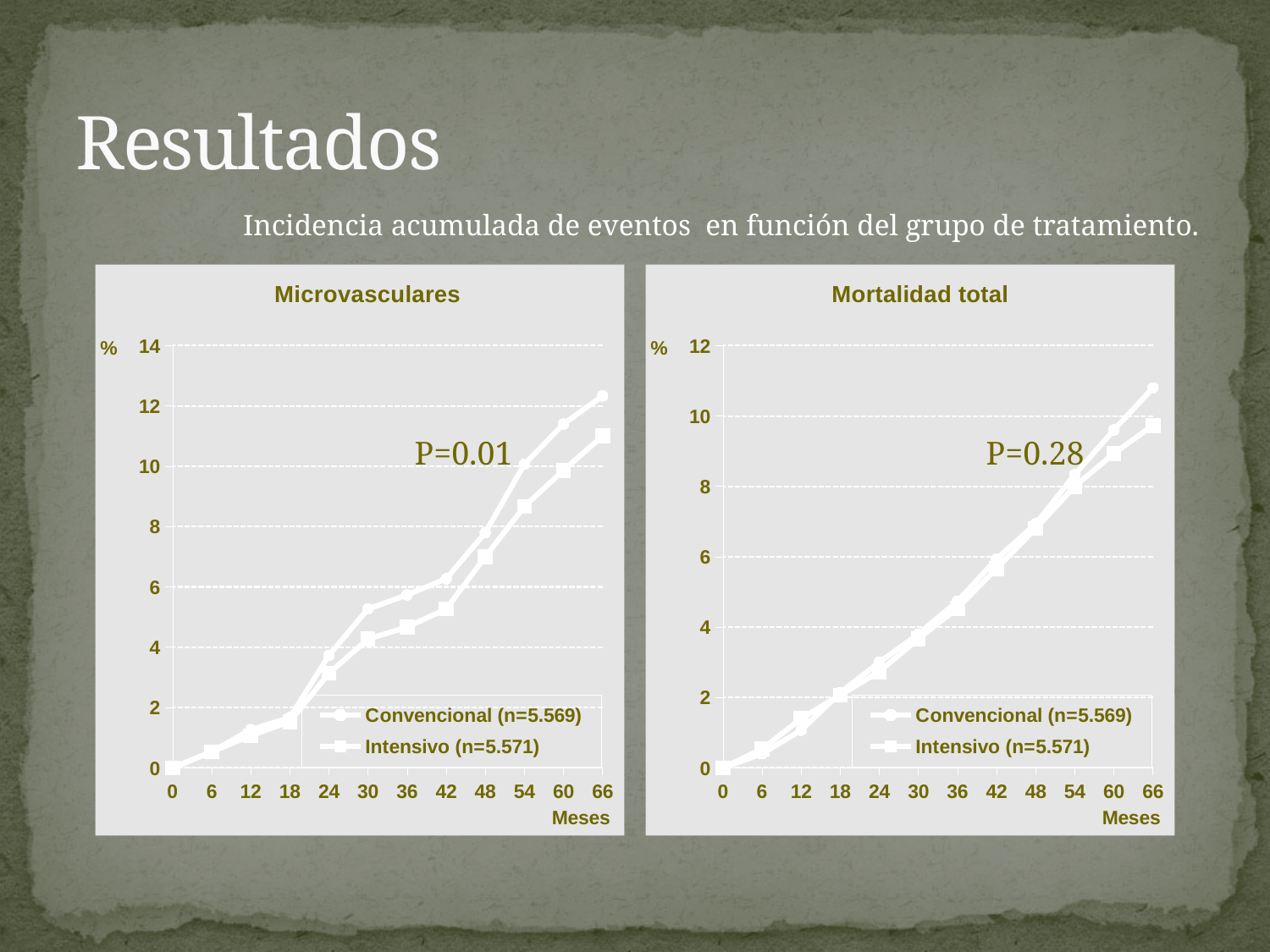
What P value is shown on the 'Microvasculares' chart? P=0.01 What kind of chart is the 'Microvasculares' chart? line chart In the 'Microvasculares' chart, is the value for Convencional (n=5.569) at 60 months greater or less than 10? greater In the 'Microvasculares' chart, how many time points are marked on the x axis? 12 In the 'Mortalidad total' chart, which series has the higher value at 66 months, Convencional (n=5.569) or Intensivo (n=5.571)? Convencional (n=5.569) In the 'Microvasculares' chart, is the value for Intensivo (n=5.571) at 42 months greater or less than 6? less In the 'Microvasculares' chart, which series has the higher value at 66 months, Convencional (n=5.569) or Intensivo (n=5.571)? Convencional (n=5.569) In the 'Mortalidad total' chart, is the value for Convencional (n=5.569) at 66 months greater or less than 10? greater How many series does the legend of the 'Mortalidad total' chart list? 2 What P value is shown on the 'Mortalidad total' chart? P=0.28 In the 'Mortalidad total' chart, do the values rise or fall as the months increase? rise